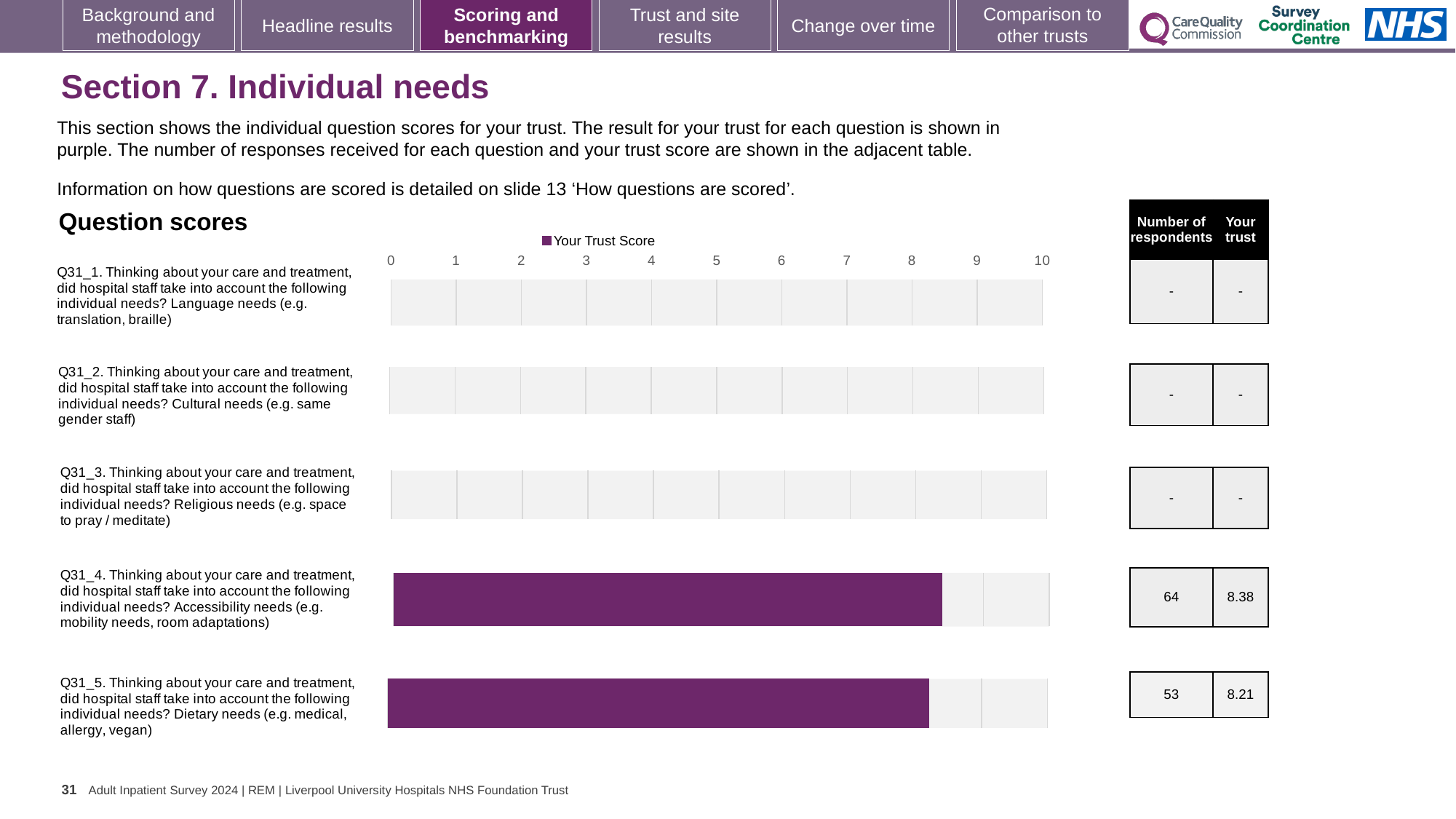
What is the difference between the trust scores for Q31_4 (Accessibility needs) and Q31_5 (Dietary needs)? 0.17 How many questions on the slide have a trust score shown as a bar (i.e. not '-')? 2 What is the single series named in the chart legend? Your Trust Score What is the trust score for Q31_5 (Dietary needs)? 8.21 What is the trust score for Q31_4 (Accessibility needs)? 8.38 How many respondents answered Q31_4 (Accessibility needs)? 64 What is the difference in the number of respondents between Q31_4 (Accessibility needs) and Q31_5 (Dietary needs)? 11 How many respondents answered Q31_5 (Dietary needs)? 53 Is the trust score for Q31_4 (Accessibility needs) greater or less than 8? greater What kind of chart is used to show the question scores? Bar chart Which question has the higher trust score, Q31_4 (Accessibility needs) or Q31_5 (Dietary needs)? Q31_4 (Accessibility needs) Is the trust score for Q31_5 (Dietary needs) greater or less than 9? less